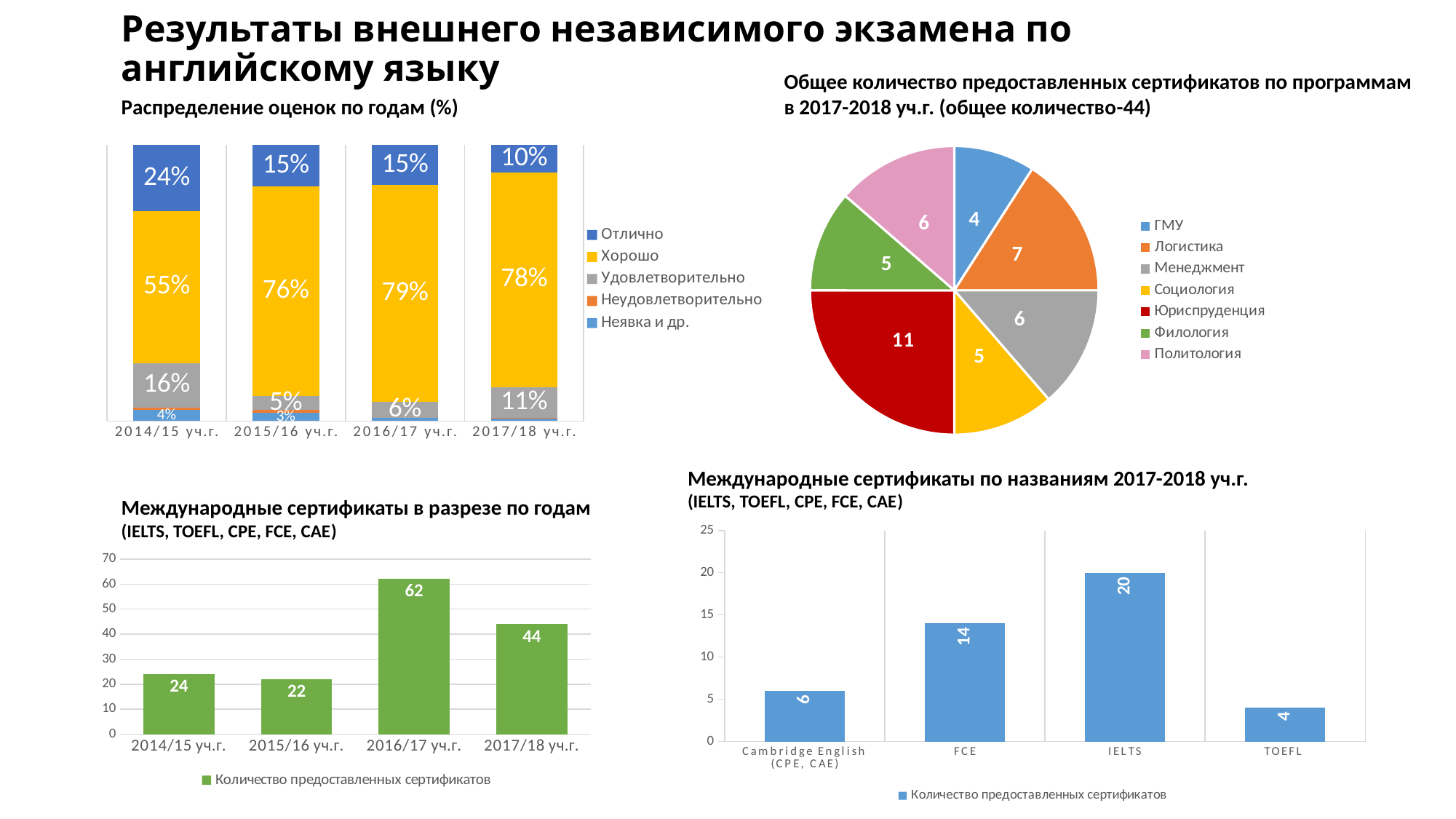
In the chart 'Международные сертификаты по названиям 2017-2018 уч.г.', what is the value for IELTS? 20 In the chart 'Распределение оценок по годам (%)', what is the value for 'Хорошо' in 2016/17 уч.г.? 79% In the pie chart 'Общее количество предоставленных сертификатов по программам в 2017-2018 уч.г.', what is the difference between Юриспруденция and ГМУ? 7 What kind of chart is 'Международные сертификаты по названиям 2017-2018 уч.г.'? bar chart In the pie chart 'Общее количество предоставленных сертификатов по программам в 2017-2018 уч.г.', which programme has the largest slice? Юриспруденция In the chart 'Международные сертификаты по названиям 2017-2018 уч.г.', which is larger, FCE or TOEFL? FCE In the pie chart 'Общее количество предоставленных сертификатов по программам в 2017-2018 уч.г.', what is the value for Логистика? 7 In the chart 'Распределение оценок по годам (%)', how many series does the legend list? 5 In the chart 'Международные сертификаты в разрезе по годам', what is the difference between 2016/17 уч.г. and 2017/18 уч.г.? 18 In the chart 'Распределение оценок по годам (%)', what is the value for 'Отлично' in 2014/15 уч.г.? 24% In the chart 'Международные сертификаты в разрезе по годам', which year has the lowest value? 2015/16 уч.г. In the chart 'Международные сертификаты в разрезе по годам', what is the value for 2016/17 уч.г.? 62